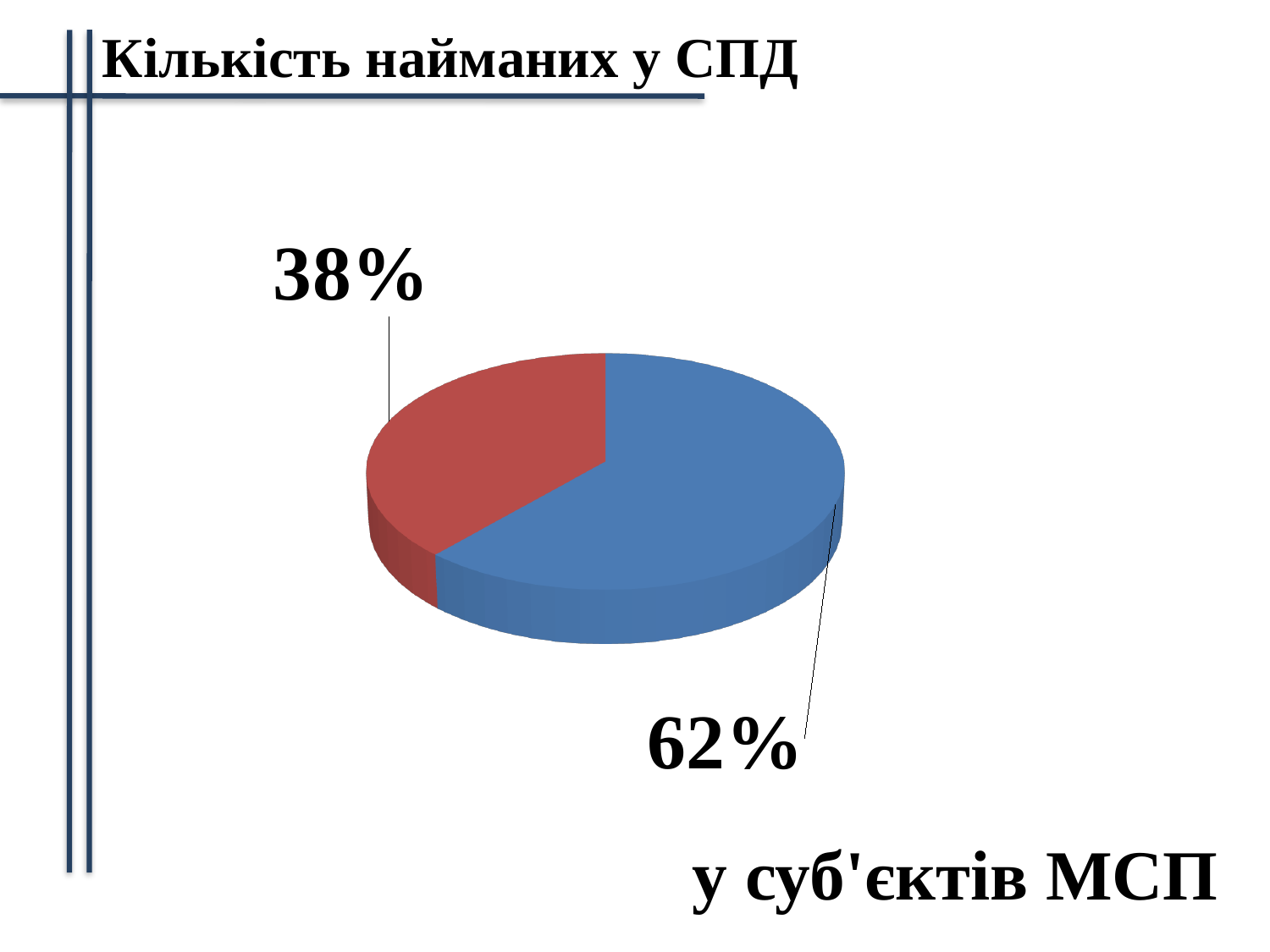
What percentage is shown for the red slice of the pie chart? 38% What is the title of the chart on the slide? Кількість найманих у СПД What is the difference in percentage points between the blue slice and the red slice? 24 What kind of chart is shown on the slide? pie chart Which is larger, the red slice or the blue slice? the blue slice What colour is the slice labelled 62%? blue Is the share of the red slice greater or less than 50%? less Which slice of the pie chart is the smallest? the red slice (38%) What percentage is shown for the blue slice of the pie chart? 62% How many slices does the pie chart have? 2 Which slice of the pie chart is the largest? the blue slice (62%)